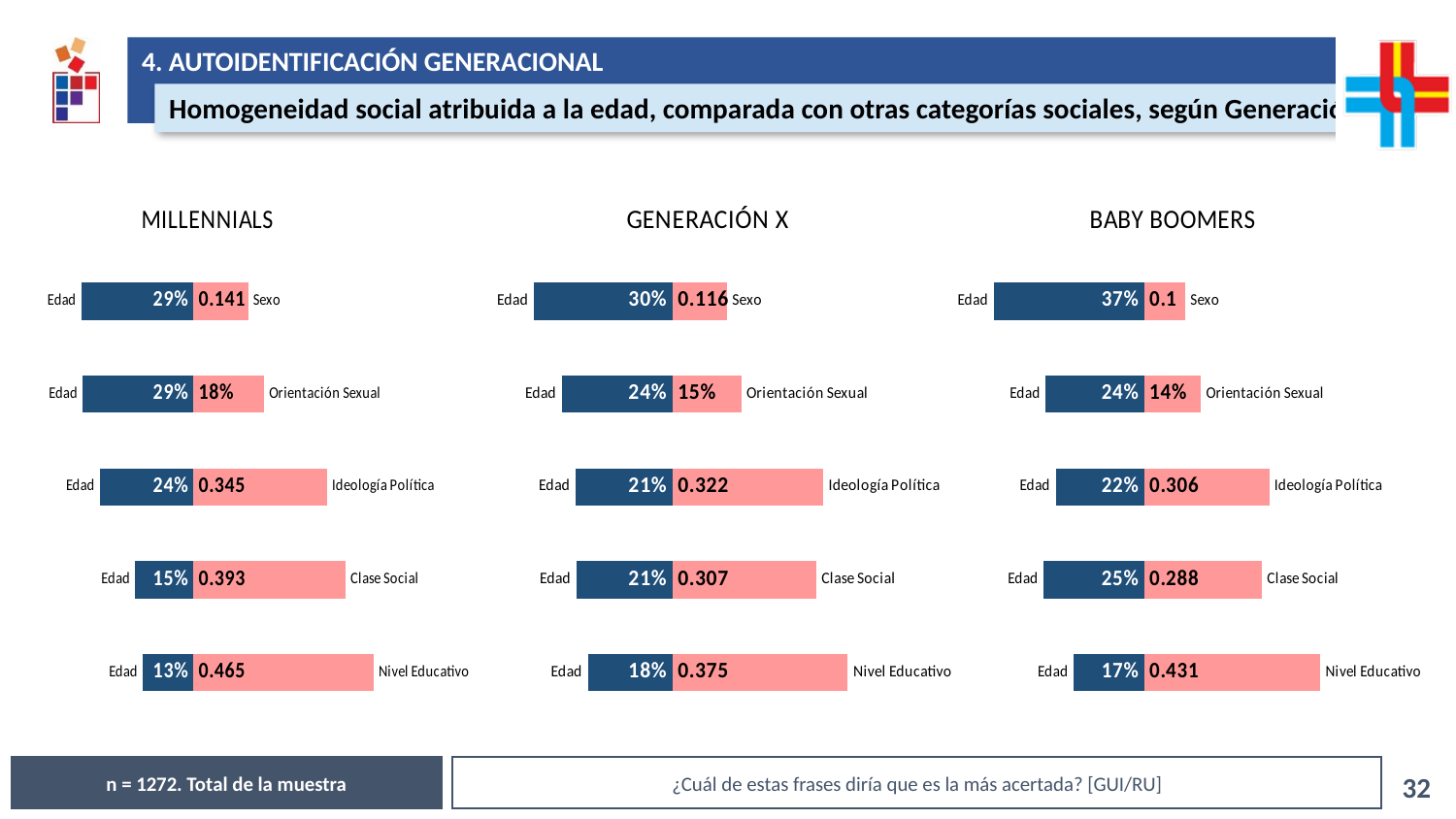
In the BABY BOOMERS chart, what value is shown for Ideología Política? 0.306 How many charts are shown on the slide? 3 In the BABY BOOMERS chart, which row has the highest Edad value? Sexo In the MILLENNIALS chart, what value is shown for Orientación Sexual? 18% What kind of chart is used for the MILLENNIALS data? Bar chart How many category rows does the BABY BOOMERS chart have? 5 In the MILLENNIALS chart, what is the Edad value in the Nivel Educativo row? 13% In the GENERACIÓN X chart, what is the Edad value in the Sexo row? 30% In the GENERACIÓN X chart, which is larger: the Edad value in the Orientación Sexual row or the Edad value in the Nivel Educativo row? Orientación Sexual In the MILLENNIALS chart, what is the difference between the Edad value in the Sexo row and the Edad value in the Clase Social row? 14% In the MILLENNIALS chart, which row has the lowest Edad value? Nivel Educativo In the GENERACIÓN X chart, which row has the highest value for the non-Edad category? Nivel Educativo